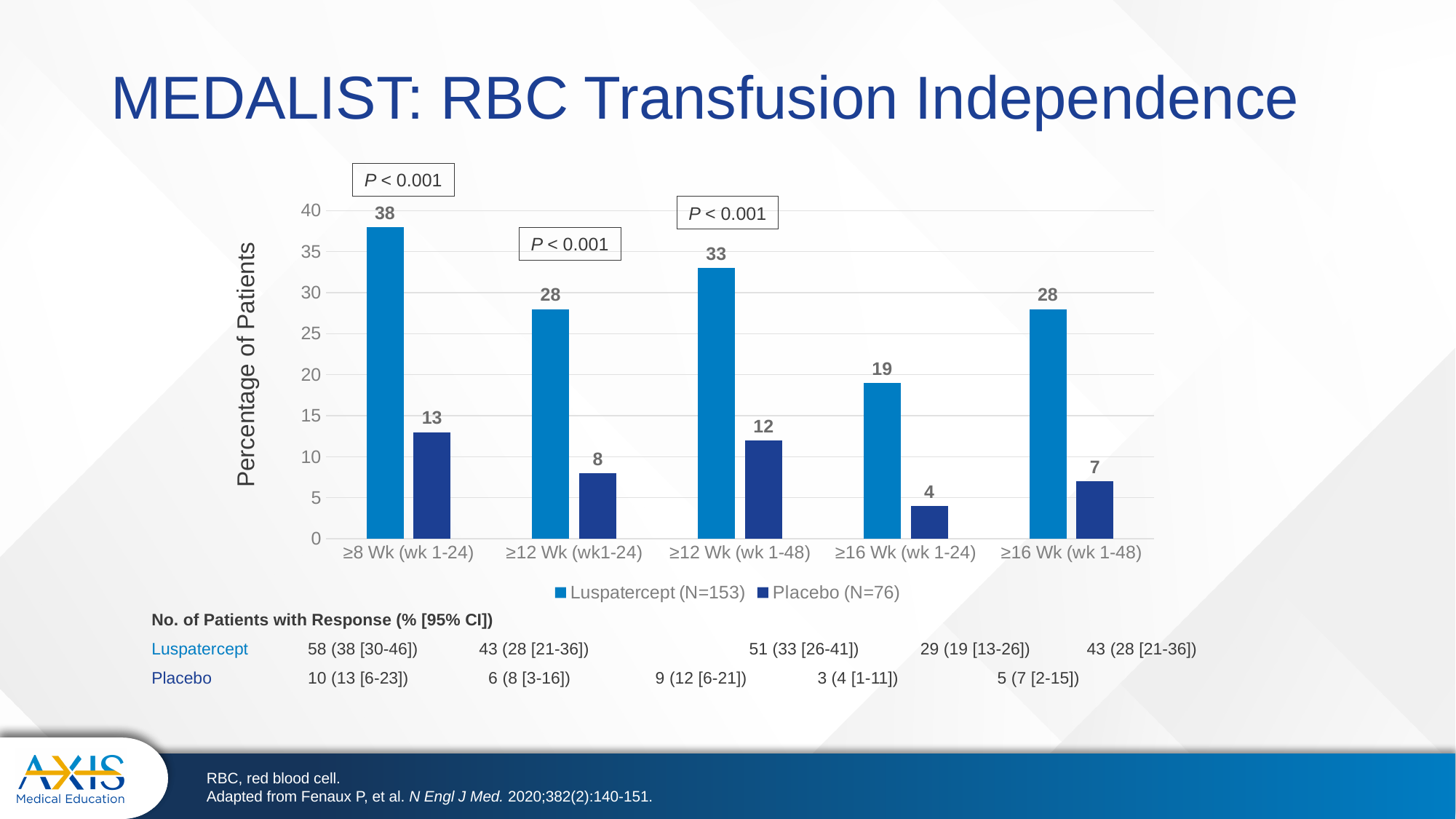
What kind of chart is shown on the slide? Bar chart What is the value for Luspatercept (N=153) in the ≥16 Wk (wk 1-24) category? 19 What is the difference between the Luspatercept (N=153) and Placebo (N=76) values in the ≥12 Wk (wk1-24) category? 20 What is the value for Placebo (N=76) in the ≥12 Wk (wk 1-48) category? 12 How many categories are shown on the x axis? 5 How many series does the legend list? 2 Which category has the lowest value for Placebo (N=76)? ≥16 Wk (wk 1-24) Which is larger in the ≥16 Wk (wk 1-48) category: Luspatercept (N=153) or Placebo (N=76)? Luspatercept (N=153) What is the value for Placebo (N=76) in the ≥16 Wk (wk 1-24) category? 4 What is the y-axis label of the chart? Percentage of Patients Which category has the highest value for Luspatercept (N=153)? ≥8 Wk (wk 1-24) What is the value for Luspatercept (N=153) in the ≥8 Wk (wk 1-24) category? 38